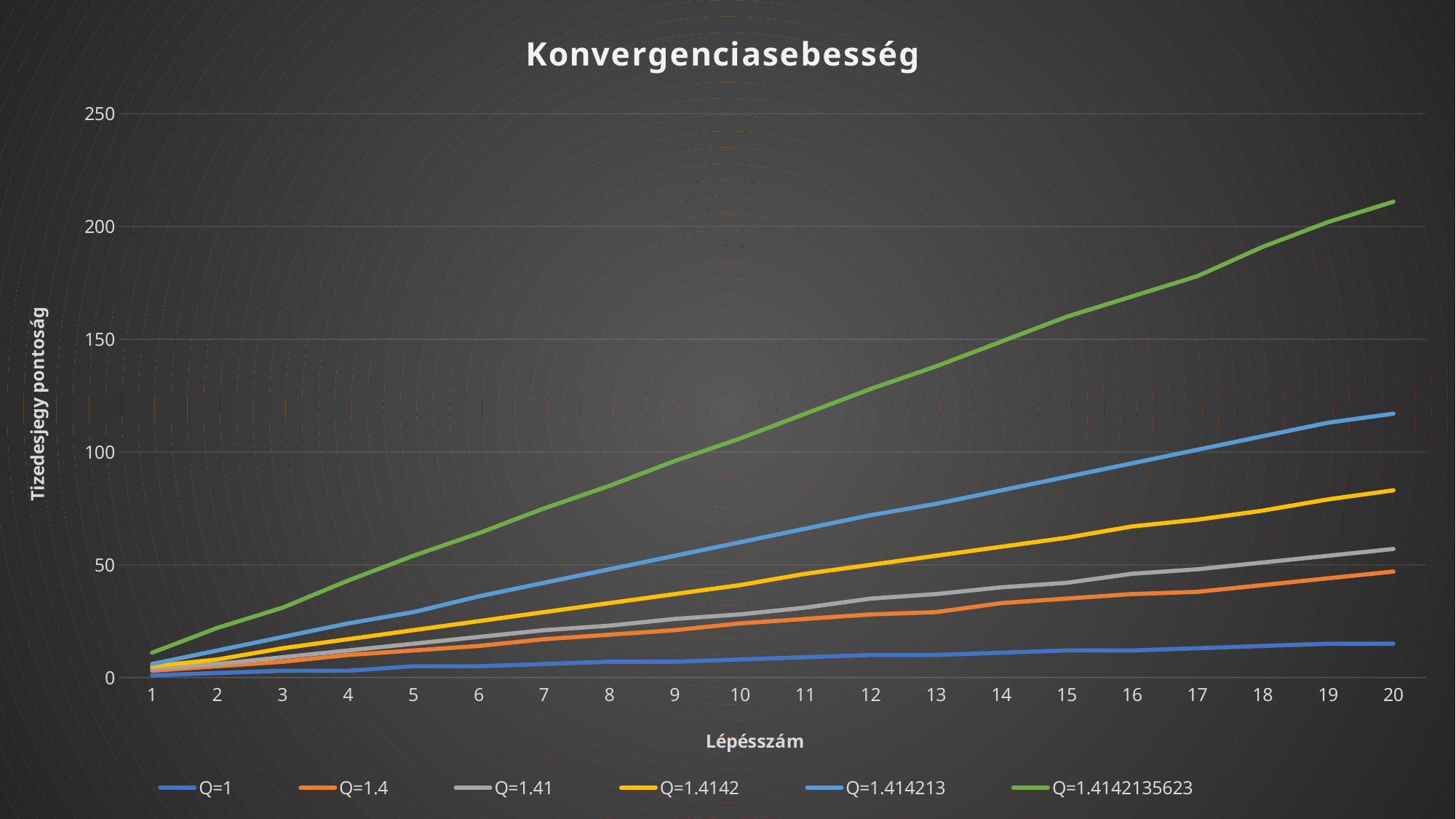
What is the title of the chart? Konvergenciasebesség How many series does the legend list? 6 Is the value for Q=1.4142135623 at step 20 greater or less than 200? greater Is the value for Q=1.4142 at step 20 greater or less than 100? less Which is larger at step 20: the value for Q=1.414213 or the value for Q=1.4142? Q=1.414213 How many steps (Lépésszám values) are plotted along the x axis? 20 Which series has the lowest value at step 20? Q=1 What is the label of the y axis? Tizedesjegy pontosság What kind of chart is shown on the slide? line chart Is the value for Q=1.414213 at step 20 greater or less than 100? greater Do the values for Q=1.4142135623 rise or fall as the step number increases? rise Which series has the highest value at step 20? Q=1.4142135623